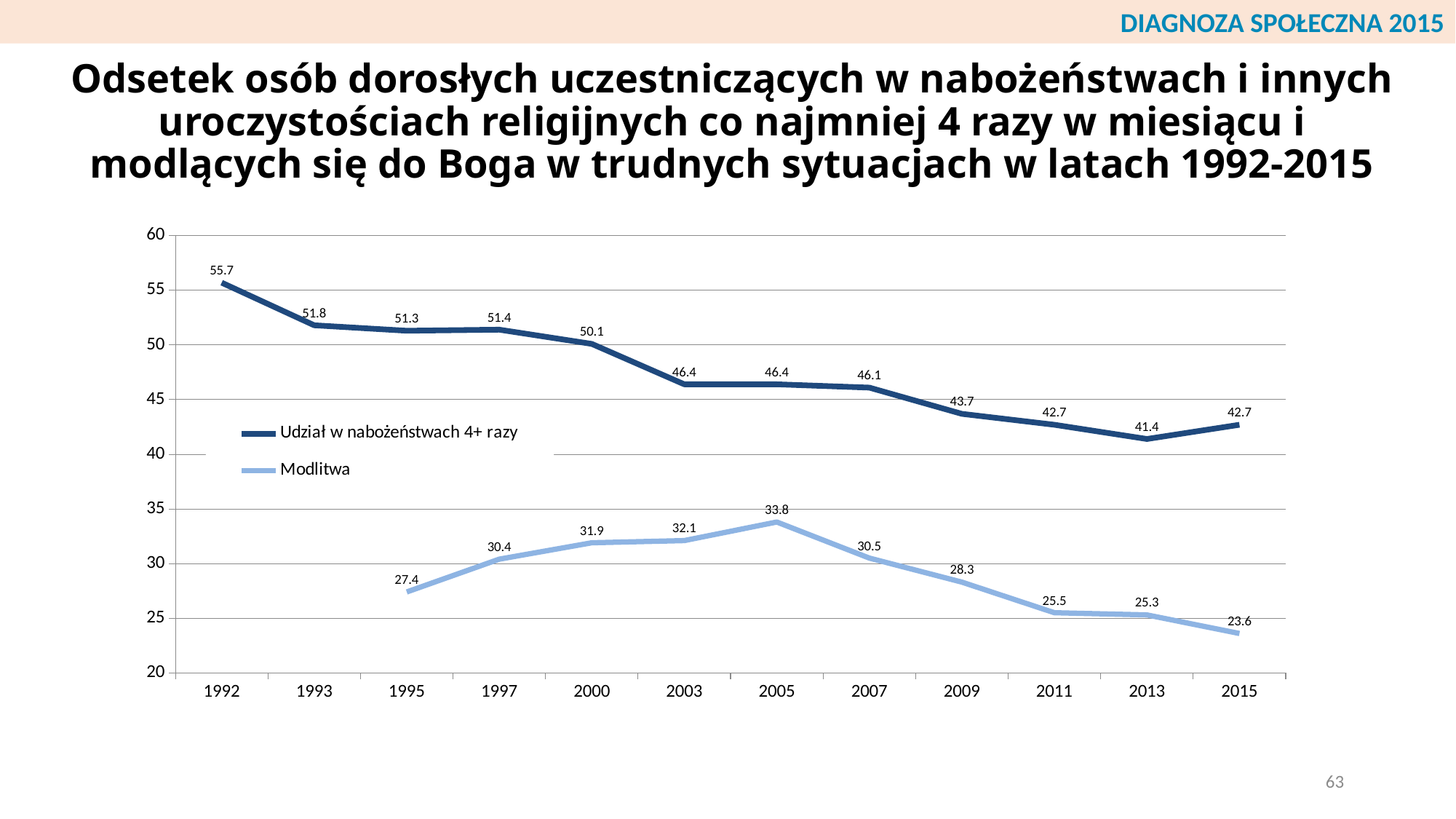
How many series does the legend list? 2 In which year is the 'Modlitwa' series highest? 2005 Which series has the higher value in 2009, 'Udział w nabożeństwach 4+ razy' or 'Modlitwa'? Udział w nabożeństwach 4+ razy How many years are shown on the x axis? 12 In which year is the 'Udział w nabożeństwach 4+ razy' series lowest? 2013 What is the difference between the 'Modlitwa' values in 2005 and 2015? 10.2 What is the value for 'Udział w nabożeństwach 4+ razy' in 1992? 55.7 What is the value for 'Modlitwa' in 2015? 23.6 What is the value for 'Modlitwa' in 2005? 33.8 Does the 'Udział w nabożeństwach 4+ razy' series generally rise or fall from 1992 to 2013? fall What is the difference between the 'Udział w nabożeństwach 4+ razy' values in 1992 and 2015? 13 What kind of chart is shown on the slide? line chart